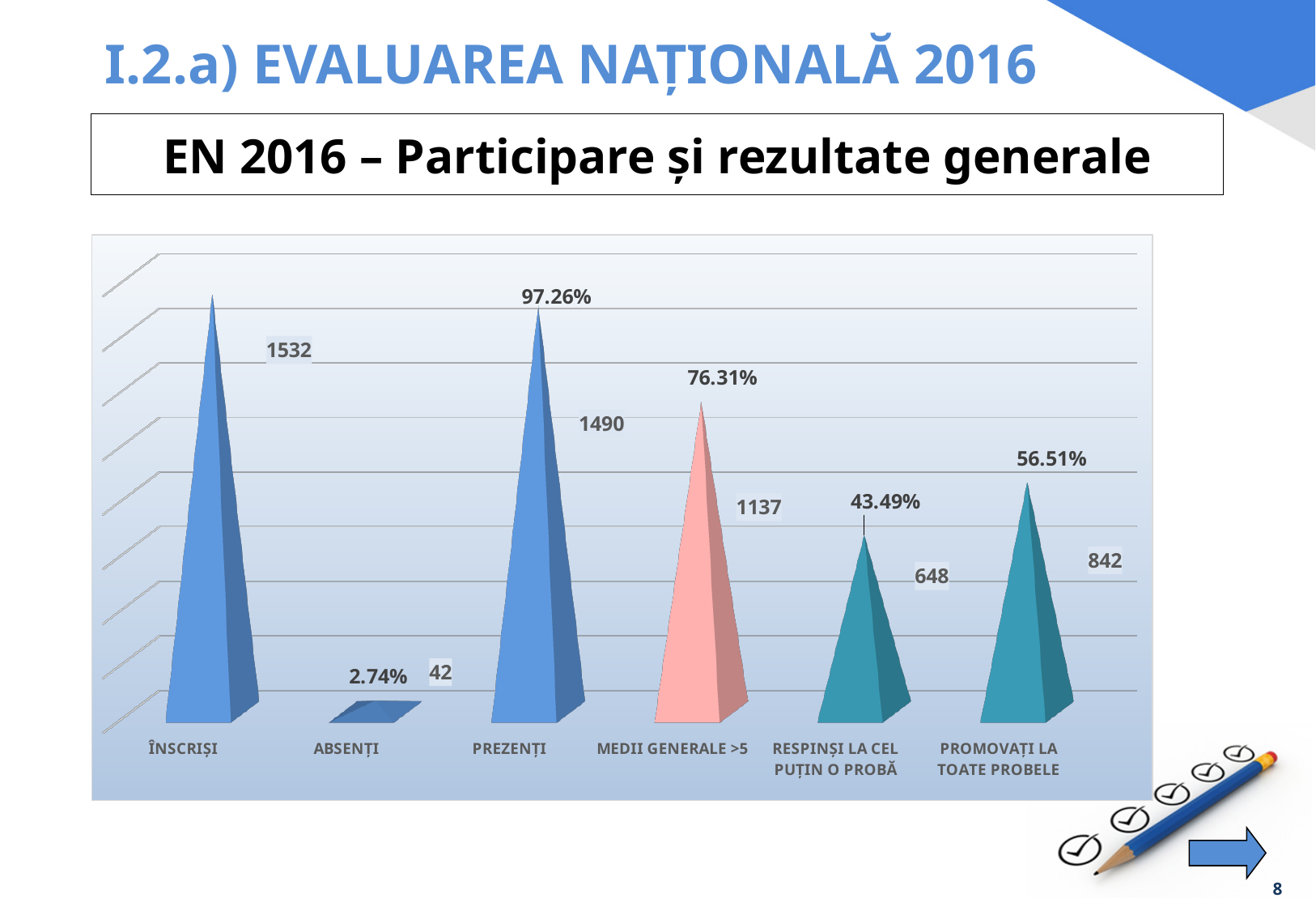
What is the value shown for ÎNSCRIȘI? 1532 What is the count shown for PROMOVAȚI LA TOATE PROBELE? 842 What is the value shown for ABSENȚI? 42 How many categories are shown on the x axis? 6 Which category has the lowest value? ABSENȚI What is the difference between the counts for ÎNSCRIȘI and PREZENȚI? 42 Which is larger, the count for PROMOVAȚI LA TOATE PROBELE or the count for RESPINȘI LA CEL PUȚIN O PROBĂ? PROMOVAȚI LA TOATE PROBELE What kind of chart is shown on the slide? Bar chart What is the count shown for MEDII GENERALE >5? 1137 What percentage is shown for PREZENȚI? 97.26% What percentage is shown for RESPINȘI LA CEL PUȚIN O PROBĂ? 43.49% Which category has the highest value? ÎNSCRIȘI